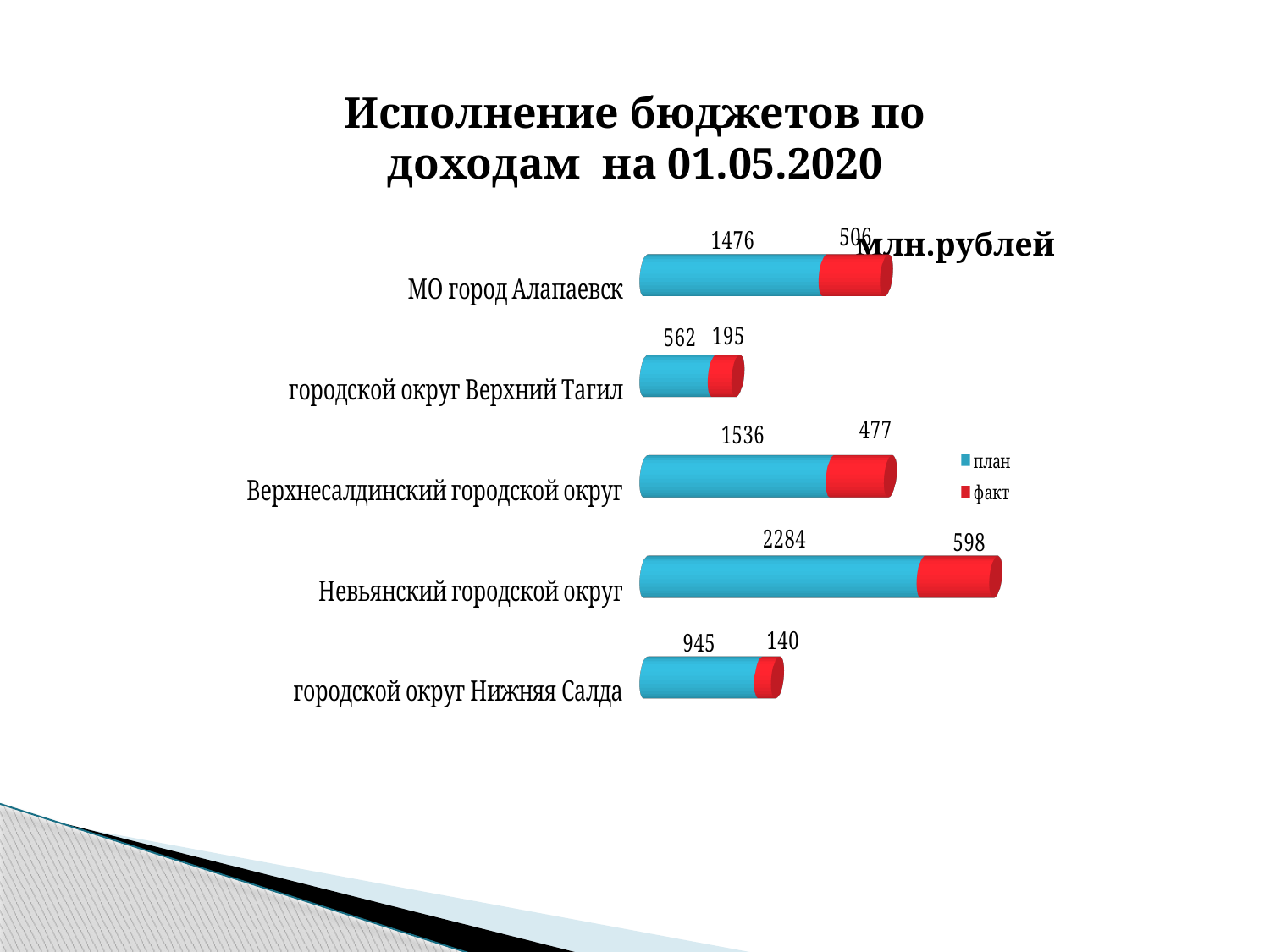
What is the план value for городской округ Нижняя Салда? 945 Which has the larger план value: МО город Алапаевск or Верхнесалдинский городской округ? Верхнесалдинский городской округ How many series does the legend list? 2 What is the факт value for городской округ Верхний Тагил? 195 Which category has the lowest факт value? городской округ Нижняя Салда What is the difference between the план and факт values for Верхнесалдинский городской округ? 1059 What colour represents the факт series? red What kind of chart is shown on the slide? bar chart What is the план value for Невьянский городской округ? 2284 How many categories are shown in the chart? 5 What is the total of the stacked bar for Невьянский городской округ? 2882 Which category has the highest план value? Невьянский городской округ